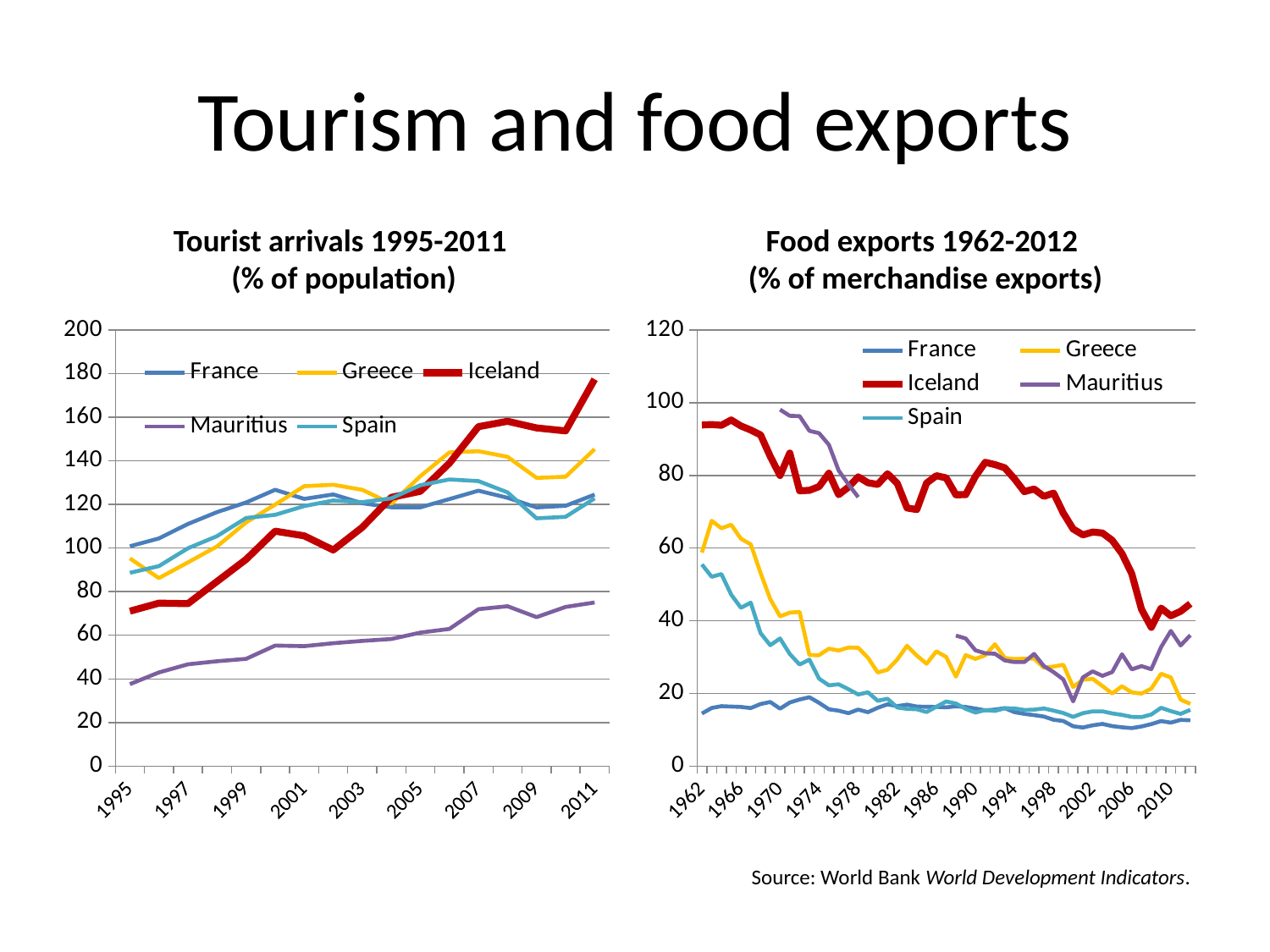
How many series does the legend of the 'Food exports 1962-2012' chart list? 5 In the 'Food exports 1962-2012' chart, does the Spain line rise or fall from 1962 to 2012? fall In the 'Tourist arrivals 1995-2011' chart, does the Mauritius line rise or fall from 1995 to 2011? rise In the 'Food exports 1962-2012' chart, is the value for Iceland in 1962 greater or less than 80? greater In the 'Food exports 1962-2012' chart, which is larger in 2012, Mauritius or Greece? Mauritius In the 'Tourist arrivals 1995-2011' chart, which country has the lowest values throughout the period? Mauritius In the 'Tourist arrivals 1995-2011' chart, is the value for Iceland in 2011 greater or less than 160? greater What is the title of the chart on the right of the slide? Food exports 1962-2012 (% of merchandise exports) In the 'Tourist arrivals 1995-2011' chart, which country has the highest value in 2011? Iceland What kind of chart is the 'Tourist arrivals 1995-2011' chart? line chart In the 'Tourist arrivals 1995-2011' chart, is the value for Mauritius in 2011 greater or less than 80? less